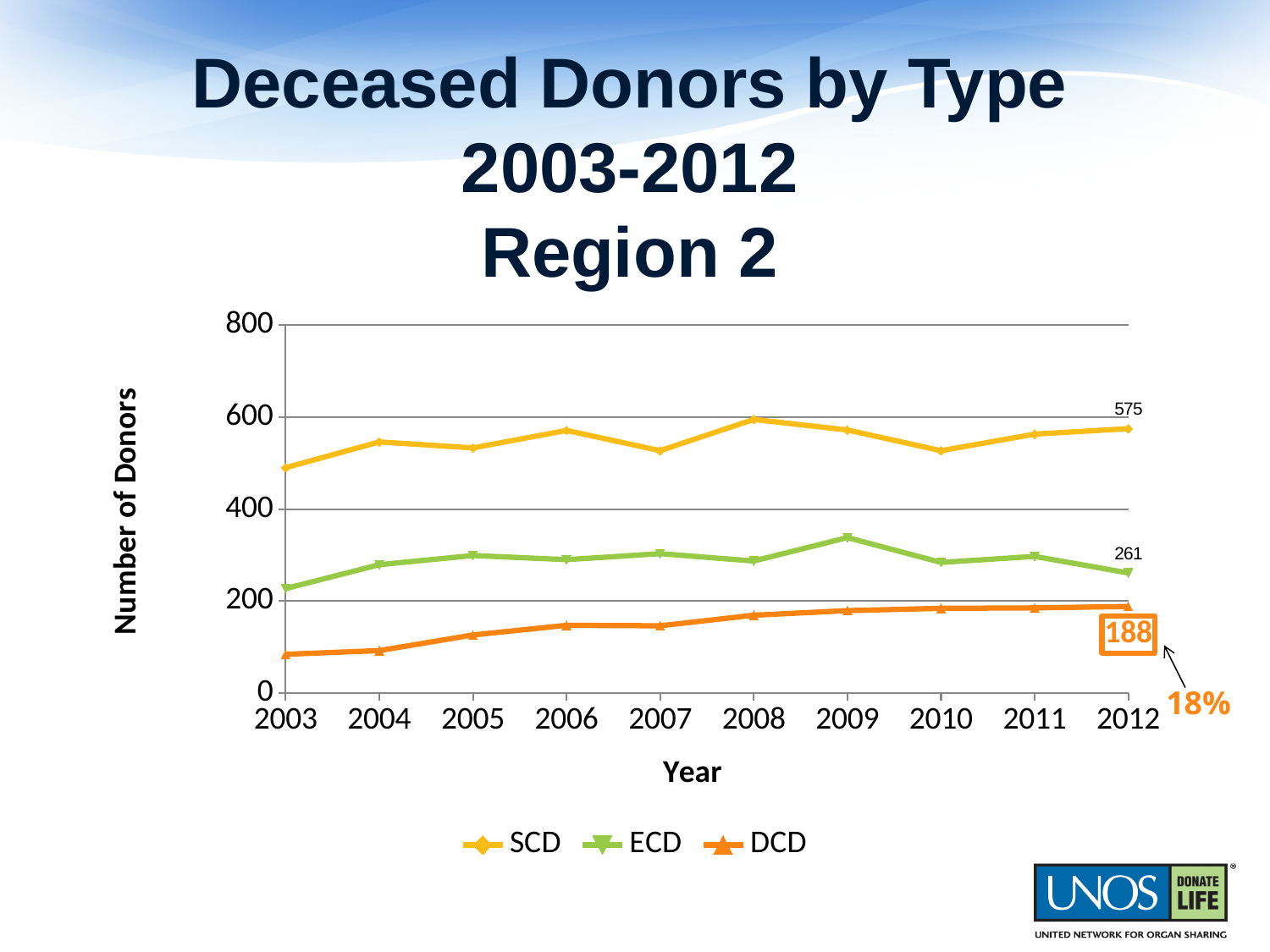
What is the difference between the ECD and DCD values in 2012? 73 Is the value for DCD in 2003 greater or less than 200? less What kind of chart is shown on the slide? line chart What is the value for ECD in 2012? 261 Which series has the lowest value in 2012? DCD Which series has the highest value in 2012? SCD What is the value for DCD in 2012? 188 How many years are shown on the x axis? 10 What is the value for SCD in 2012? 575 Is the value for SCD in 2003 greater or less than 600? less What is the difference between the SCD and ECD values in 2012? 314 How many series does the legend list? 3